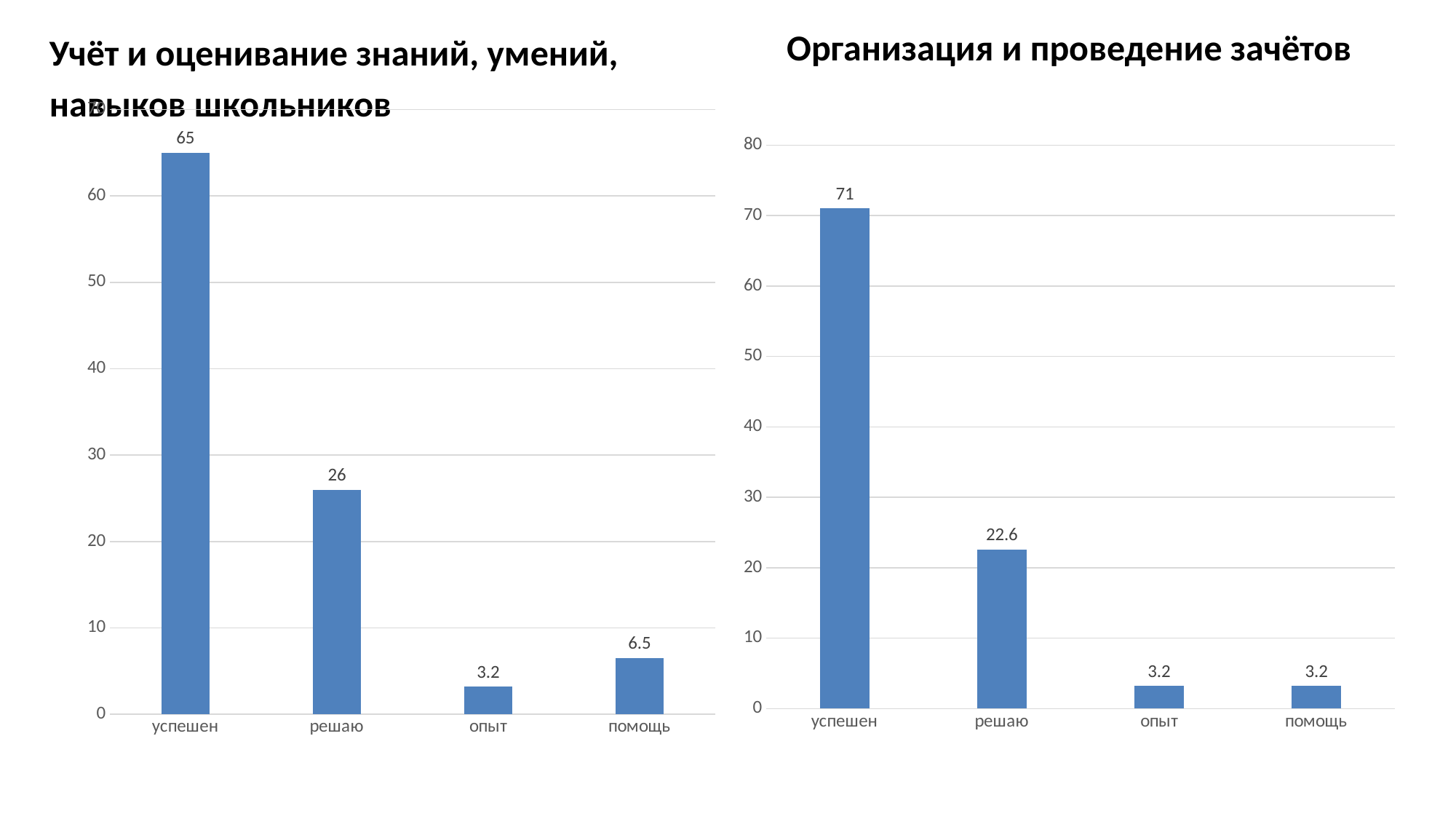
In the left chart (Учёт и оценивание знаний, умений, навыков школьников), what is the value for помощь? 6.5 In the right chart (Организация и проведение зачётов), what is the value for опыт? 3.2 In the left chart (Учёт и оценивание знаний, умений, навыков школьников), which category has the lowest value? опыт What kind of chart is the left chart (Учёт и оценивание знаний, умений, навыков школьников)? bar chart In the left chart (Учёт и оценивание знаний, умений, навыков школьников), which category has the highest value? успешен In the right chart (Организация и проведение зачётов), what is the difference between успешен and решаю? 48.4 In the left chart (Учёт и оценивание знаний, умений, навыков школьников), which is larger: решаю or помощь? решаю In the left chart (Учёт и оценивание знаний, умений, навыков школьников), what is the value for успешен? 65 In the right chart (Организация и проведение зачётов), what is the value for решаю? 22.6 In the right chart (Организация и проведение зачётов), which category has the highest value? успешен In the left chart (Учёт и оценивание знаний, умений, навыков школьников), what is the difference between успешен and решаю? 39 How many categories are shown in the right chart (Организация и проведение зачётов)? 4